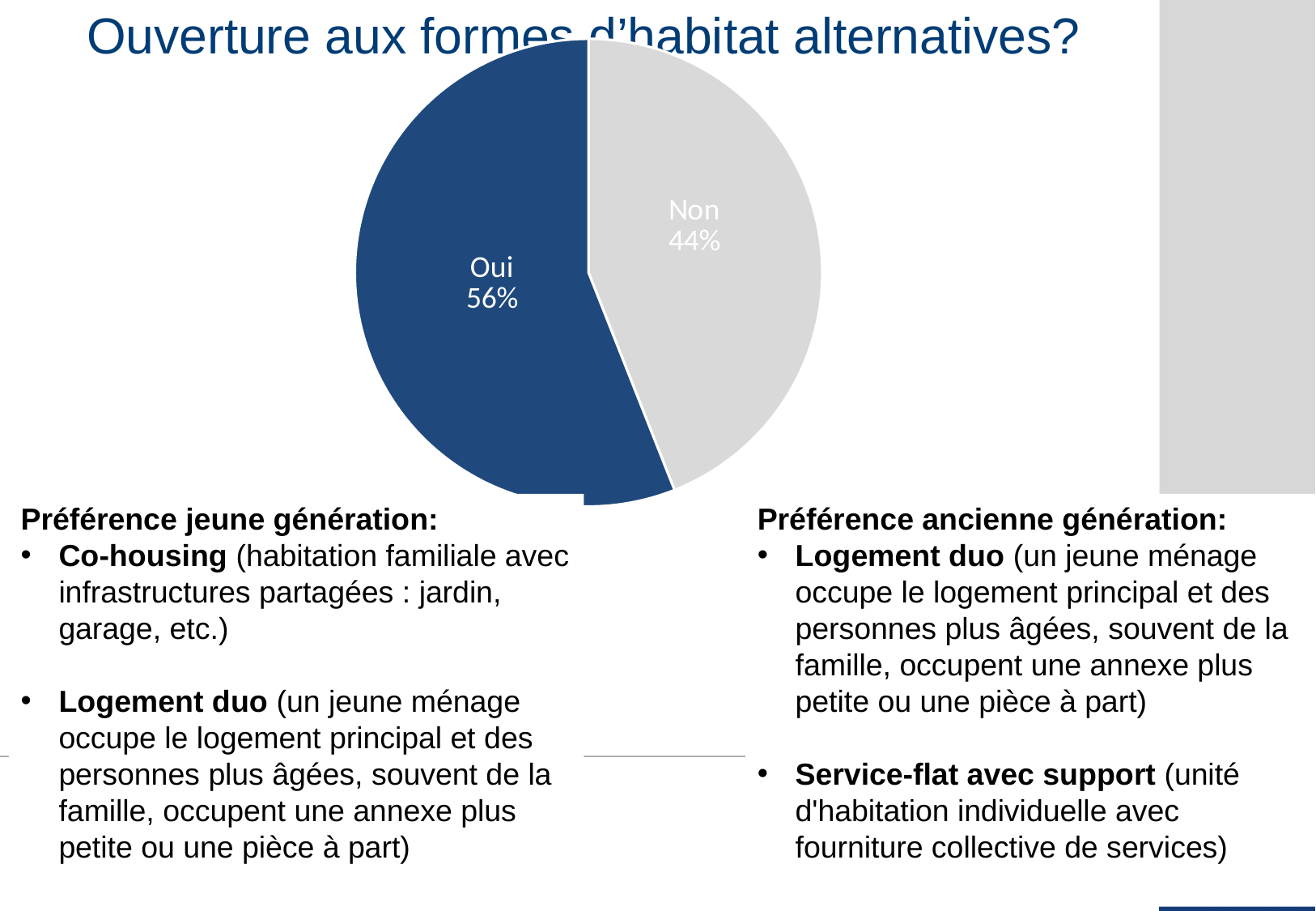
What colour is the "Non" slice of the pie? light grey What percentage of the pie is labelled "Oui"? 56% What kind of chart is shown on the slide? pie chart What is the difference in percentage points between the "Oui" and "Non" slices? 12 Which is larger, the "Oui" slice or the "Non" slice? Oui What share of the pie does the "Non" slice represent? 44% What percentage of the pie is labelled "Non"? 44% What colour is the "Oui" slice of the pie? dark blue How many slices does the pie chart have? 2 Which slice of the pie is the largest? Oui Which slice of the pie is the smallest? Non